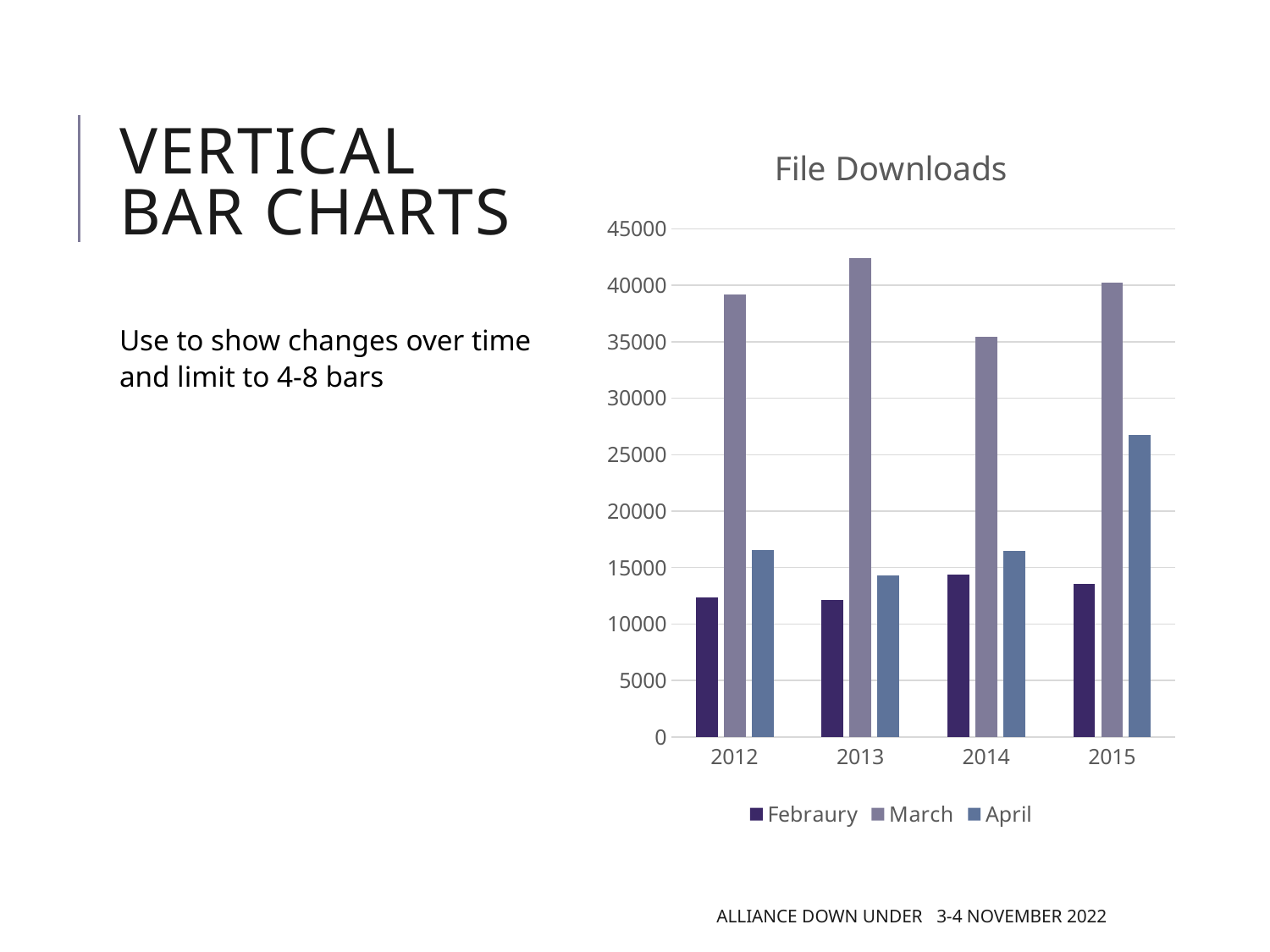
Is the March value for 2014 greater or less than 40000? less Is the March value for 2013 greater or less than 40000? greater How many years are shown on the x axis? 4 Which is larger in 2014, the Febraury value or the April value? April How many series does the legend list? 3 Is the April value for 2015 greater or less than 25000? greater Does the April value rise or fall from 2014 to 2015? rise Which year has the highest April value? 2015 What kind of chart is shown on the slide? bar chart What is the title of the chart? File Downloads Which year has the lowest March value? 2014 Which year has the highest March value? 2013